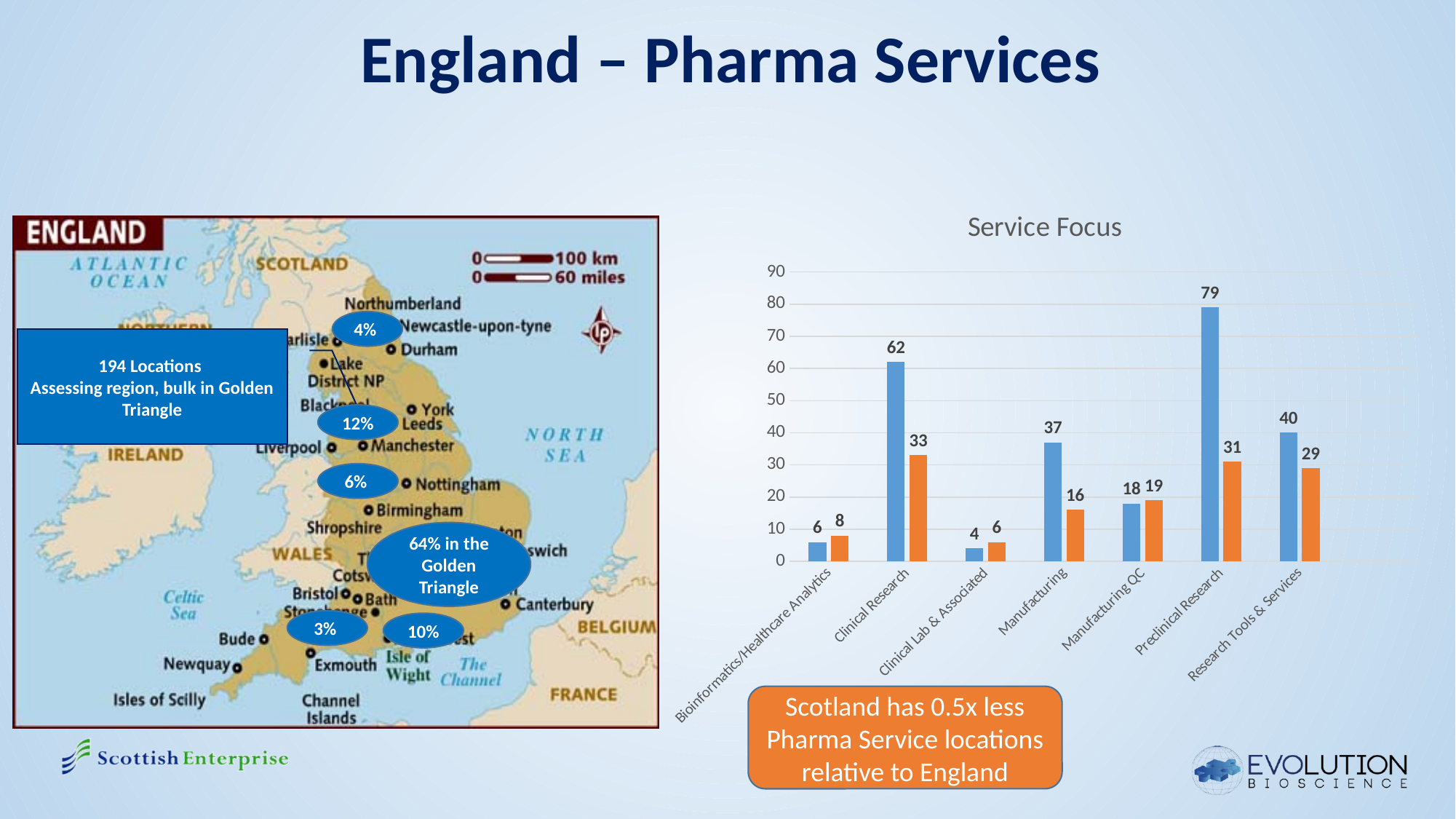
In the "Service Focus" chart, what is the value of the orange bar for Clinical Research? 33 In the "Service Focus" chart, which category has the lowest blue bar? Clinical Lab & Associated In the "Service Focus" chart, what is the difference between the blue bars for Preclinical Research and Research Tools & Services? 39 In the "Service Focus" chart, which category has the highest blue bar? Preclinical Research In the "Service Focus" chart, what is the difference between the blue and orange bars for Clinical Research? 29 In the "Service Focus" chart, what is the value of the blue bar for Manufacturing? 37 In the "Service Focus" chart, what is the value of the blue bar for Preclinical Research? 79 In the "Service Focus" chart, what is the value of the orange bar for Research Tools & Services? 29 What type of chart is the "Service Focus" chart? bar chart What is the title of the bar chart on the slide? Service Focus In the "Service Focus" chart, which is larger for Manufacturing QC: the blue bar or the orange bar? the orange bar How many categories are shown on the x axis of the "Service Focus" chart? 7